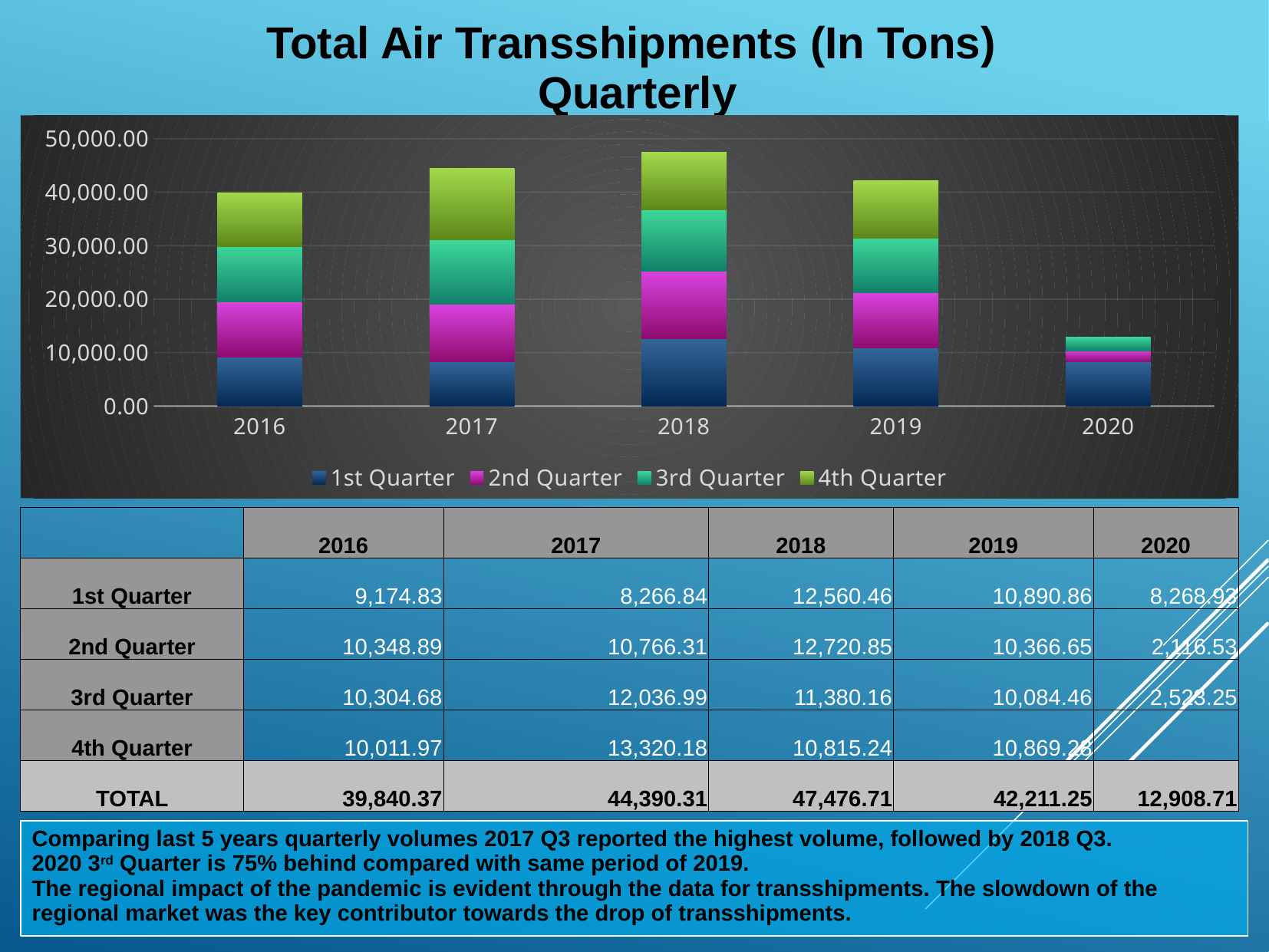
Which year has the lowest total air transshipments? 2020 Do the yearly totals rise or fall from 2018 to 2020? fall Is the total for 2020 greater or less than 20,000.00? less What is the 4th Quarter value for 2017? 13,320.18 What is the total of the stacked bar for 2018? 47,476.71 How many series does the legend list? 4 How many years are shown along the x axis of the chart? 5 Which year has the highest total air transshipments? 2018 What is the difference between the 2nd Quarter value for 2018 and the 2nd Quarter value for 2017? 1,954.54 What is the 1st Quarter value for 2016? 9,174.83 Which is larger, the 3rd Quarter value for 2017 or the 3rd Quarter value for 2018? 2017 What kind of chart is shown on the slide? stacked bar chart